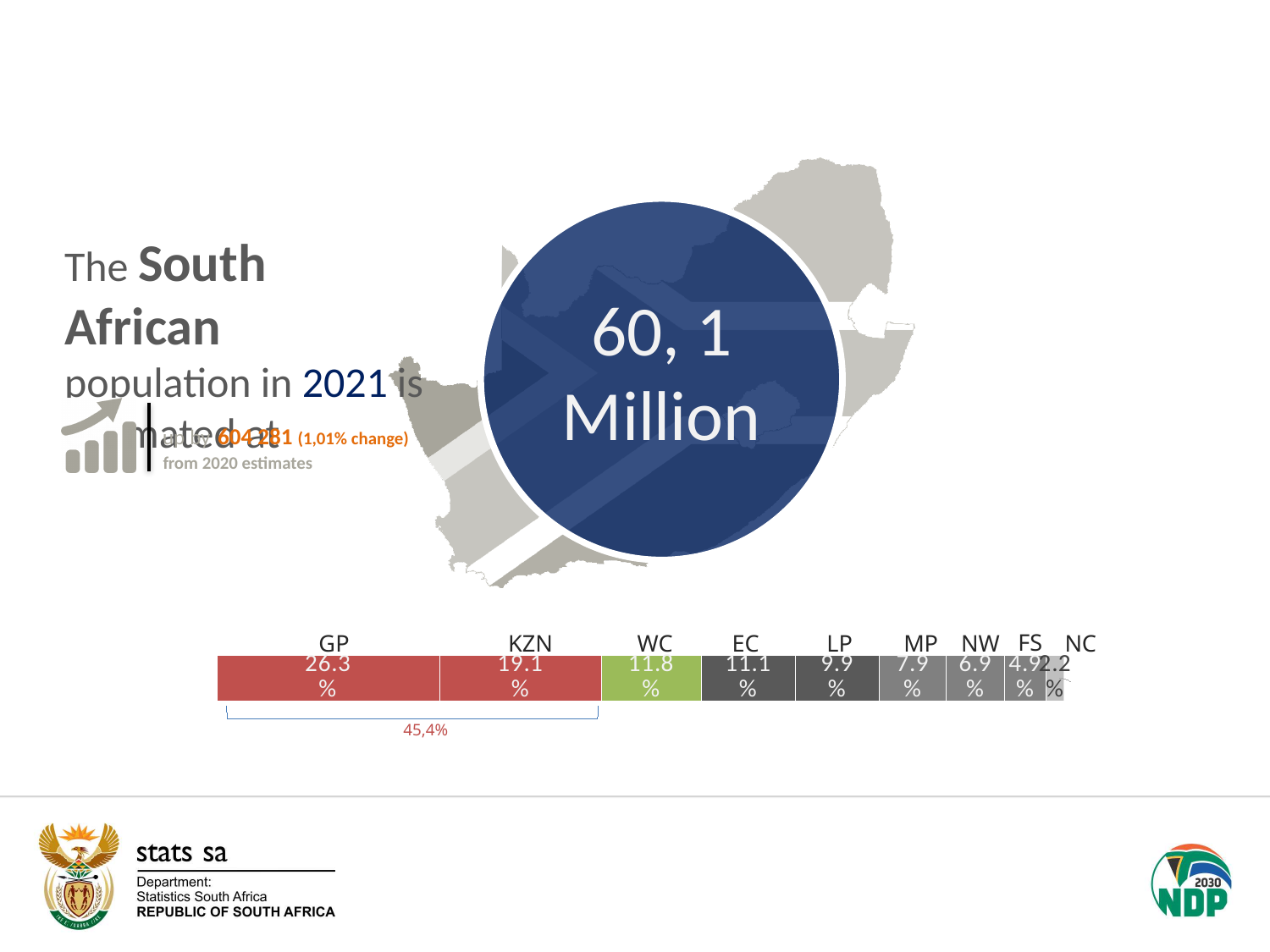
What share of the population does GP account for in the bar chart? 26.3% How many provinces are shown in the bar chart? 9 What kind of chart is used to show the provincial population shares? bar chart Which has a larger share, EC or LP? EC Which province has the smallest share in the bar chart? NC Which province has the largest share in the bar chart? GP What total population figure is shown in the large circle on the slide? 60, 1 Million What combined share is indicated by the bracket under GP and KZN? 45,4% What is the value shown for NC in the bar chart? 2.2% What is the value shown for WC in the bar chart? 11.8% What share of the population does KZN account for in the bar chart? 19.1% What is the difference between the shares of GP and KZN? 7.2%